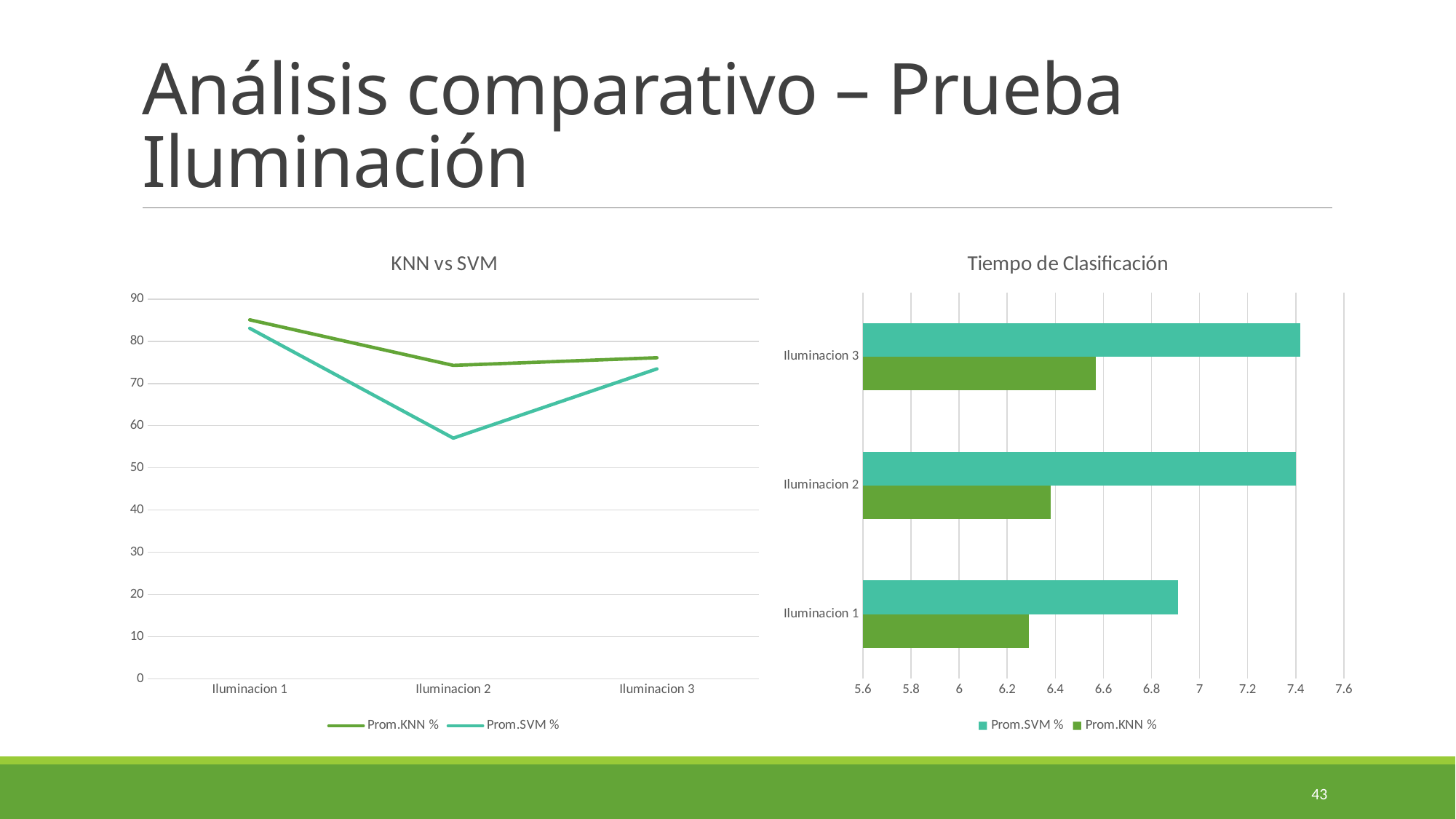
In the "KNN vs SVM" chart, is the Prom.KNN % value for Iluminacion 1 greater or less than 80? greater In the "KNN vs SVM" chart, at which category is the Prom.SVM % series lowest? Iluminacion 2 In the "Tiempo de Clasificación" chart, is the Prom.SVM % value for Iluminacion 1 greater or less than 7? less In the "Tiempo de Clasificación" chart, how many categories are shown on the vertical axis? 3 In the "KNN vs SVM" chart, does the Prom.SVM % series rise or fall from Iluminacion 1 to Iluminacion 2? fall What kind of chart is the "KNN vs SVM" chart on the left? line chart In the "KNN vs SVM" chart, at Iluminacion 2, which series has the larger value, Prom.KNN % or Prom.SVM %? Prom.KNN % What kind of chart is the "Tiempo de Clasificación" chart on the right? bar chart In the "KNN vs SVM" chart, is the Prom.SVM % value for Iluminacion 2 greater or less than 60? less In the "KNN vs SVM" chart, how many series does the legend list? 2 In the "Tiempo de Clasificación" chart, which category has the highest Prom.KNN % value? Iluminacion 3 In the "Tiempo de Clasificación" chart, for Iluminacion 1, which series has the larger value, Prom.SVM % or Prom.KNN %? Prom.SVM %